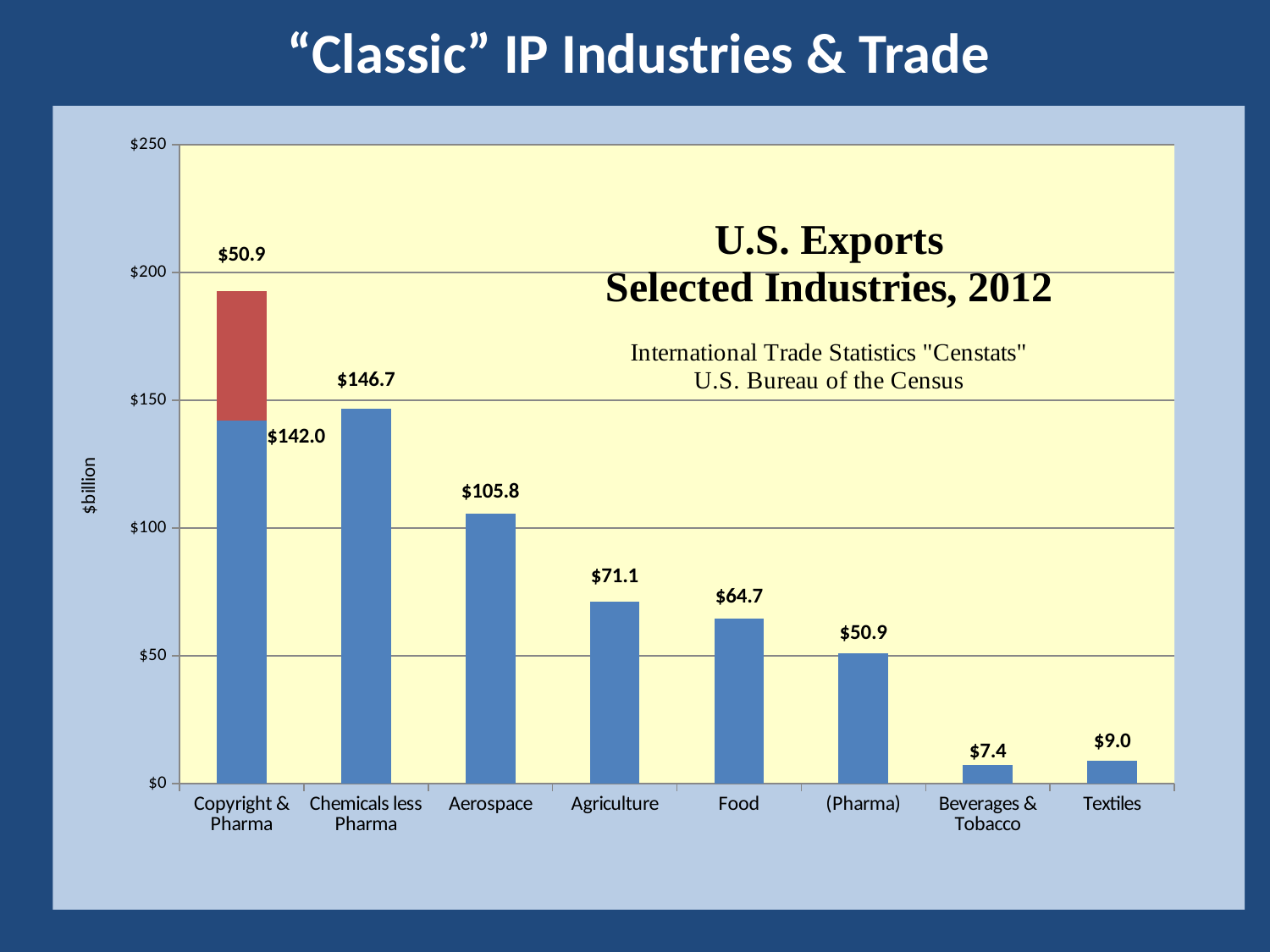
What is the value of the red segment on the Copyright & Pharma bar? $50.9 How many categories are shown on the x axis? 8 What is the difference between the values for Aerospace and Agriculture? $34.7 Which category has the tallest bar? Copyright & Pharma Which category has the lowest value? Beverages & Tobacco What is the value for Agriculture? $71.1 What is the total of the stacked Copyright & Pharma bar? $192.9 What is the value for Beverages & Tobacco? $7.4 What is the value for Aerospace? $105.8 What kind of chart is this? bar chart Which is larger, the value for Textiles or the value for Beverages & Tobacco? Textiles Is the value for Food greater or less than $50? greater